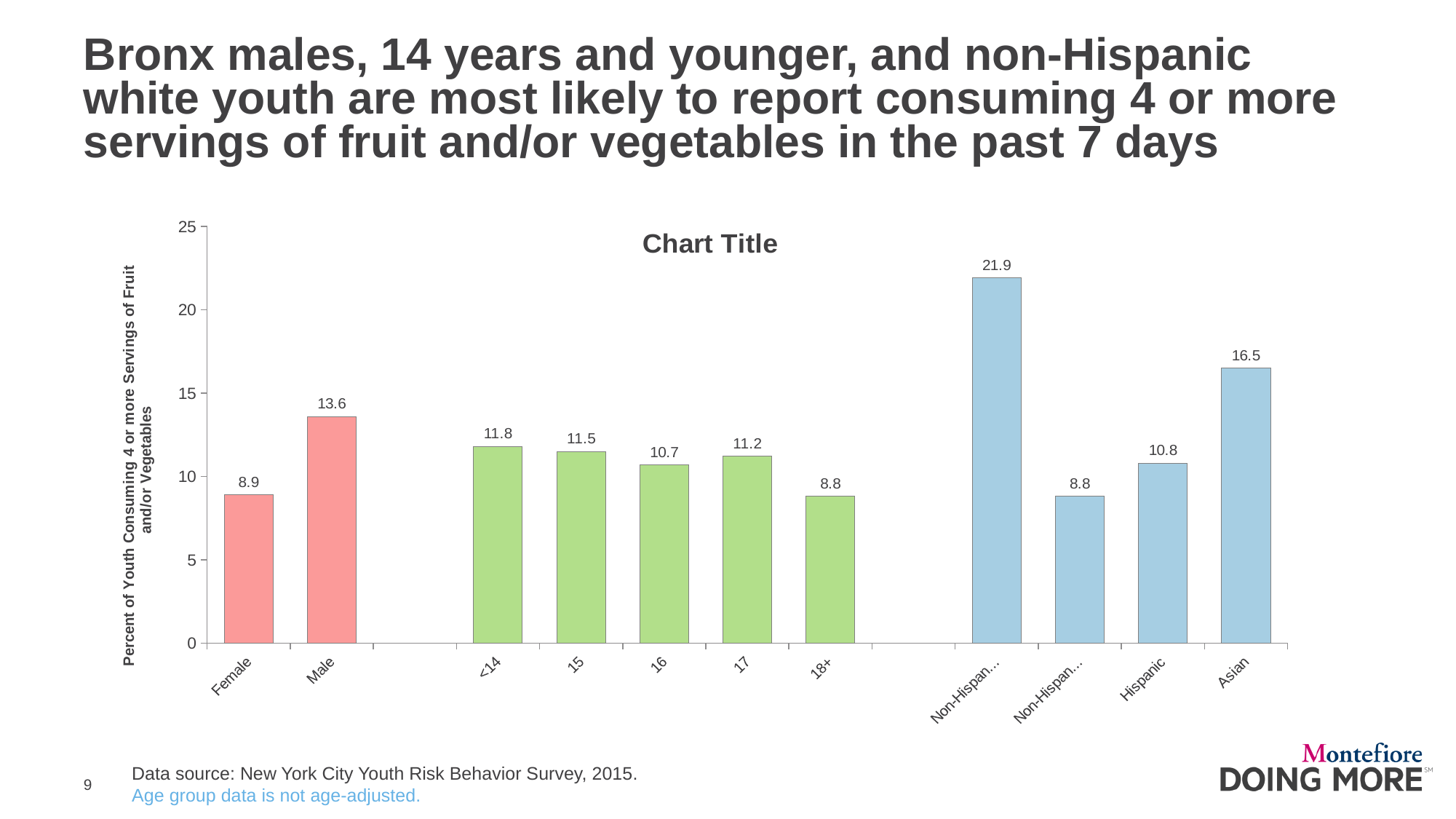
What is the value for the <14 age group? 11.8 Among the age groups (<14, 15, 16, 17, 18+), which has the lowest value? 18+ What is the value for Male? 13.6 Is the value for Male greater or less than 10? greater What is the value for Asian? 16.5 Which is larger, the value for Asian or the value for Hispanic? Asian What is the value for Hispanic? 10.8 What is the difference between the values for Male and Female? 4.7 What is the value of the tallest bar on the chart? 21.9 How many bars are plotted on the chart? 11 What is the value for Female? 8.9 What type of chart is shown on the slide? Bar chart